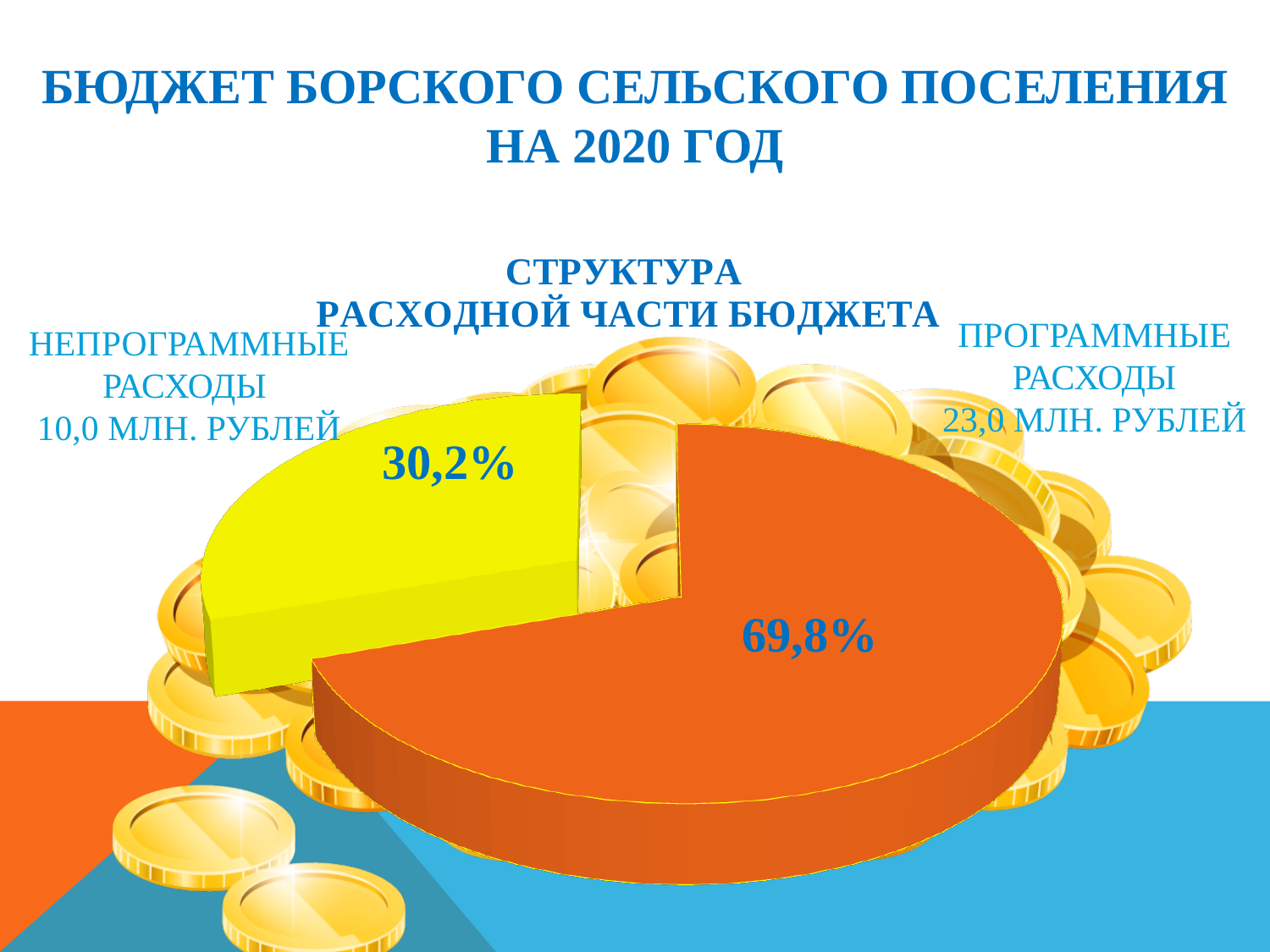
What is the value shown for "Программные расходы"? 23,0 млн. рублей What is the value shown for "Непрограммные расходы"? 10,0 млн. рублей Which category has the largest slice of the pie chart? Программные расходы What share of the pie chart does "Программные расходы" take? 69,8% What colour is the slice for "Непрограммные расходы"? yellow What is the title of the pie chart? Структура расходной части бюджета Which is larger, the share for "Программные расходы" or the share for "Непрограммные расходы"? Программные расходы Which category has the smallest slice of the pie chart? Непрограммные расходы What kind of chart is shown on the slide? pie chart What share of the pie chart does "Непрограммные расходы" take? 30,2% How many slices does the pie chart have? 2 What is the difference in percentage points between the "Программные расходы" share and the "Непрограммные расходы" share? 39,6